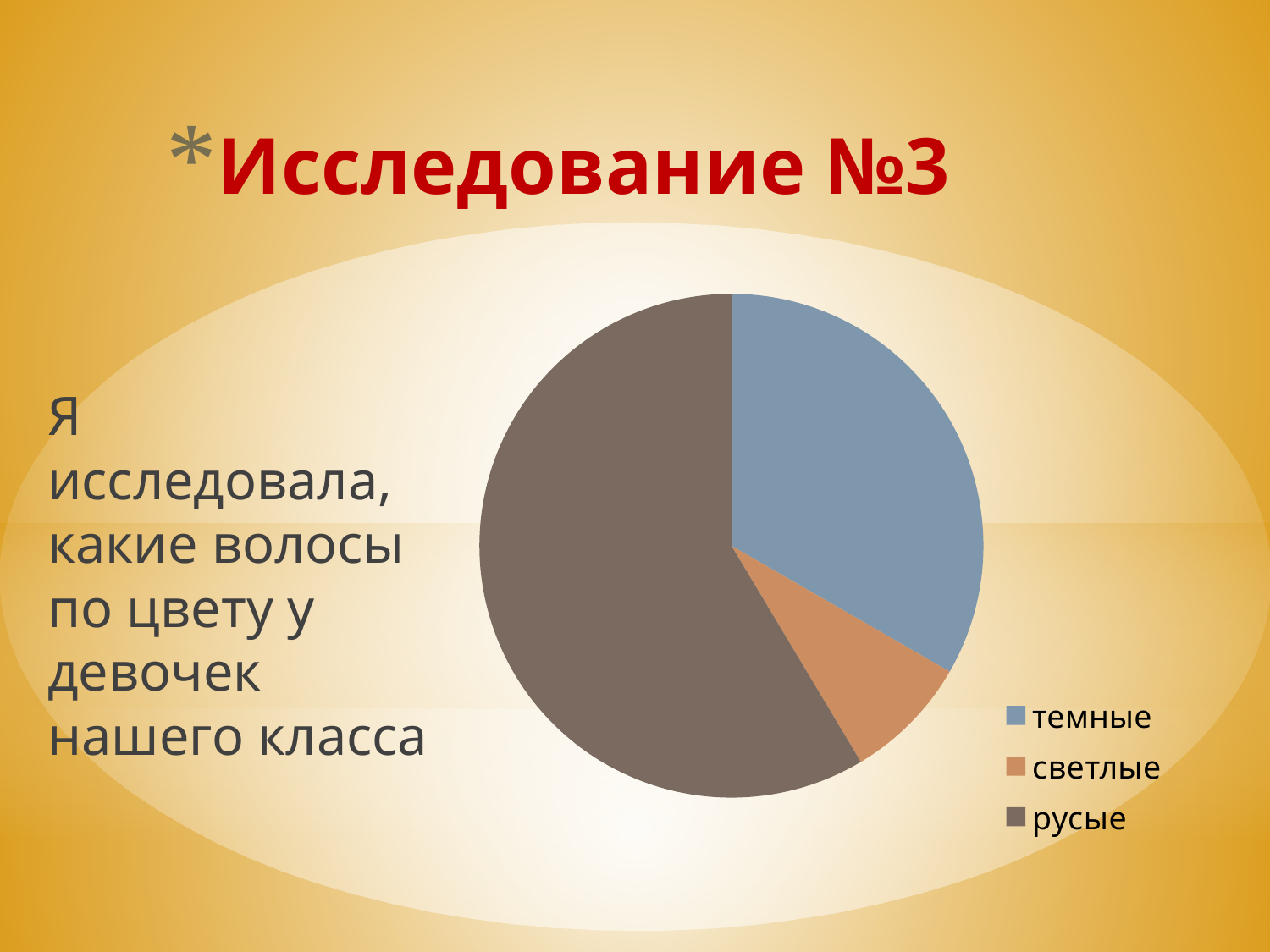
How many slices does the pie chart have? 3 Which category has the smallest slice in the pie chart? светлые What colour is the slice for темные in the pie chart? blue Which slice is larger in the pie chart, темные or светлые? темные What are the three categories listed in the legend of the pie chart? темные, светлые, русые How many entries does the legend of the pie chart list? 3 Which slice is larger in the pie chart, русые or темные? русые What kind of chart is shown on the slide? pie chart Which category has the largest slice in the pie chart? русые Does the русые slice take up more or less than half of the pie chart? more